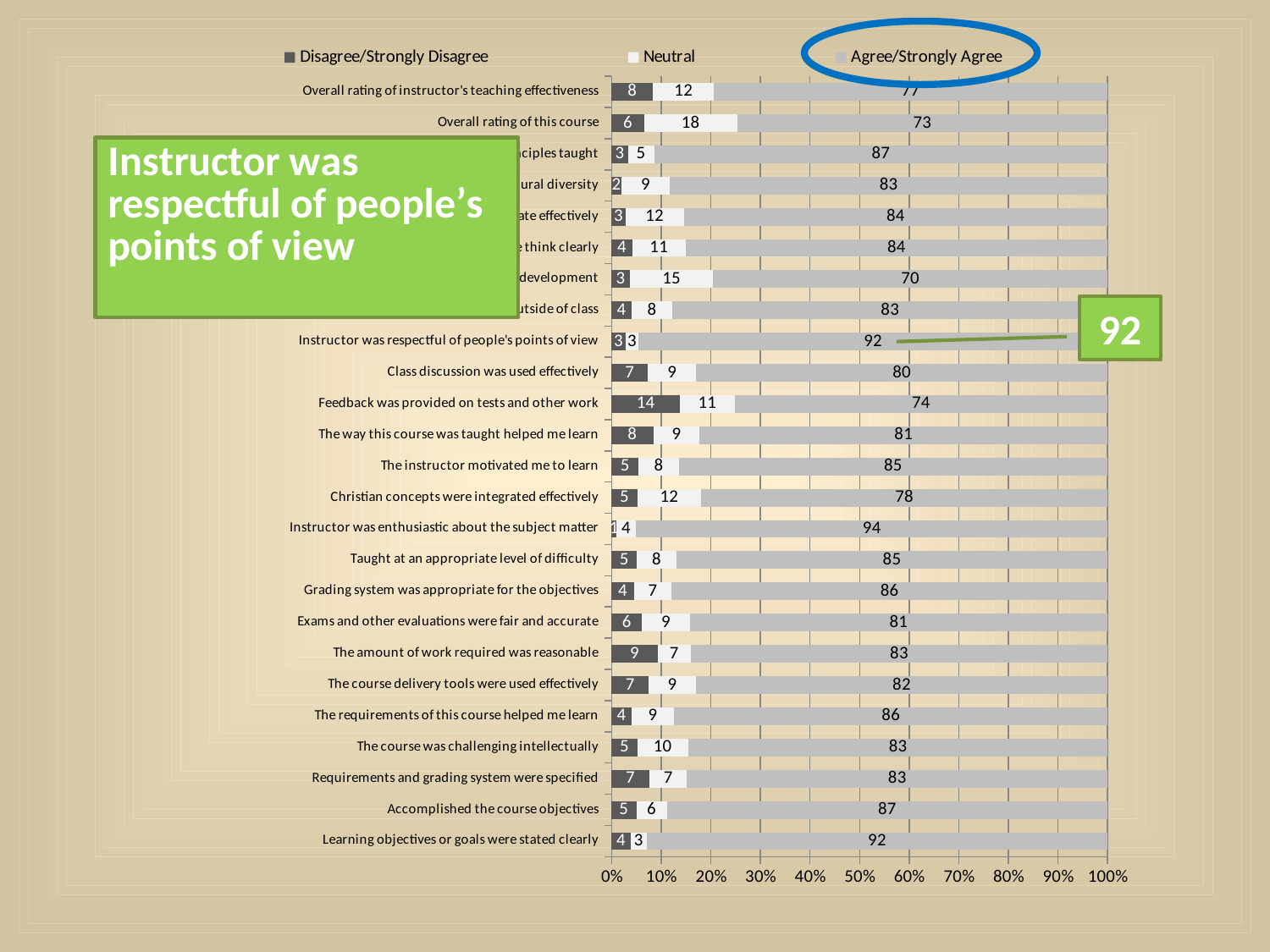
Which category has the highest Disagree/Strongly Disagree value? Feedback was provided on tests and other work Which category has the highest Neutral value? Overall rating of this course What is the difference between the Disagree/Strongly Disagree values for "Feedback was provided on tests and other work" and "Class discussion was used effectively"? 7 What is the Agree/Strongly Agree value for "Instructor was respectful of people's points of view"? 92 What is the Disagree/Strongly Disagree value for "Feedback was provided on tests and other work"? 14 Which category has the highest Agree/Strongly Agree value? Instructor was enthusiastic about the subject matter How many series does the legend list? 3 What kind of chart is shown on the slide? Stacked bar chart What is the Neutral value for "Overall rating of this course"? 18 Which legend entry is circled in blue on the slide? Agree/Strongly Agree What is the total of the three segments for "Learning objectives or goals were stated clearly"? 99 Which has a larger Agree/Strongly Agree value: "Accomplished the course objectives" or "Christian concepts were integrated effectively"? Accomplished the course objectives